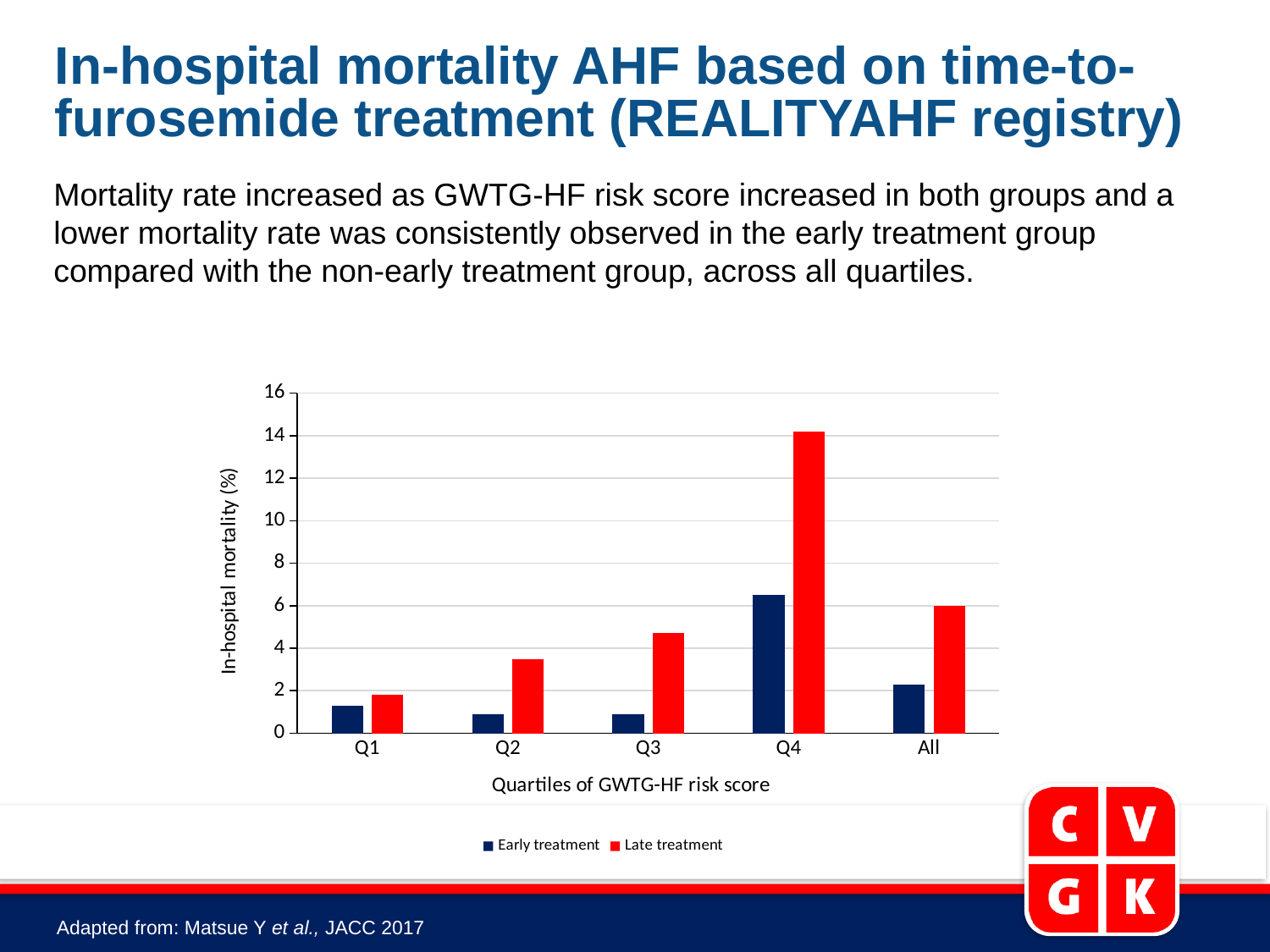
How many categories are shown on the x axis? 5 Is the Early treatment value for All greater or less than 4? less Which category has the highest in-hospital mortality for Late treatment? Q4 Is the Early treatment value for Q4 greater or less than 4? greater For Q4, which is larger: Early treatment or Late treatment? Late treatment Is the Late treatment value for Q4 greater or less than 12? greater How many series does the legend list? 2 Do the Late treatment values rise or fall from Q1 to Q4? rise Which category has the highest in-hospital mortality for Early treatment? Q4 What kind of chart is shown on the slide? bar chart Which category has the lowest in-hospital mortality for Late treatment? Q1